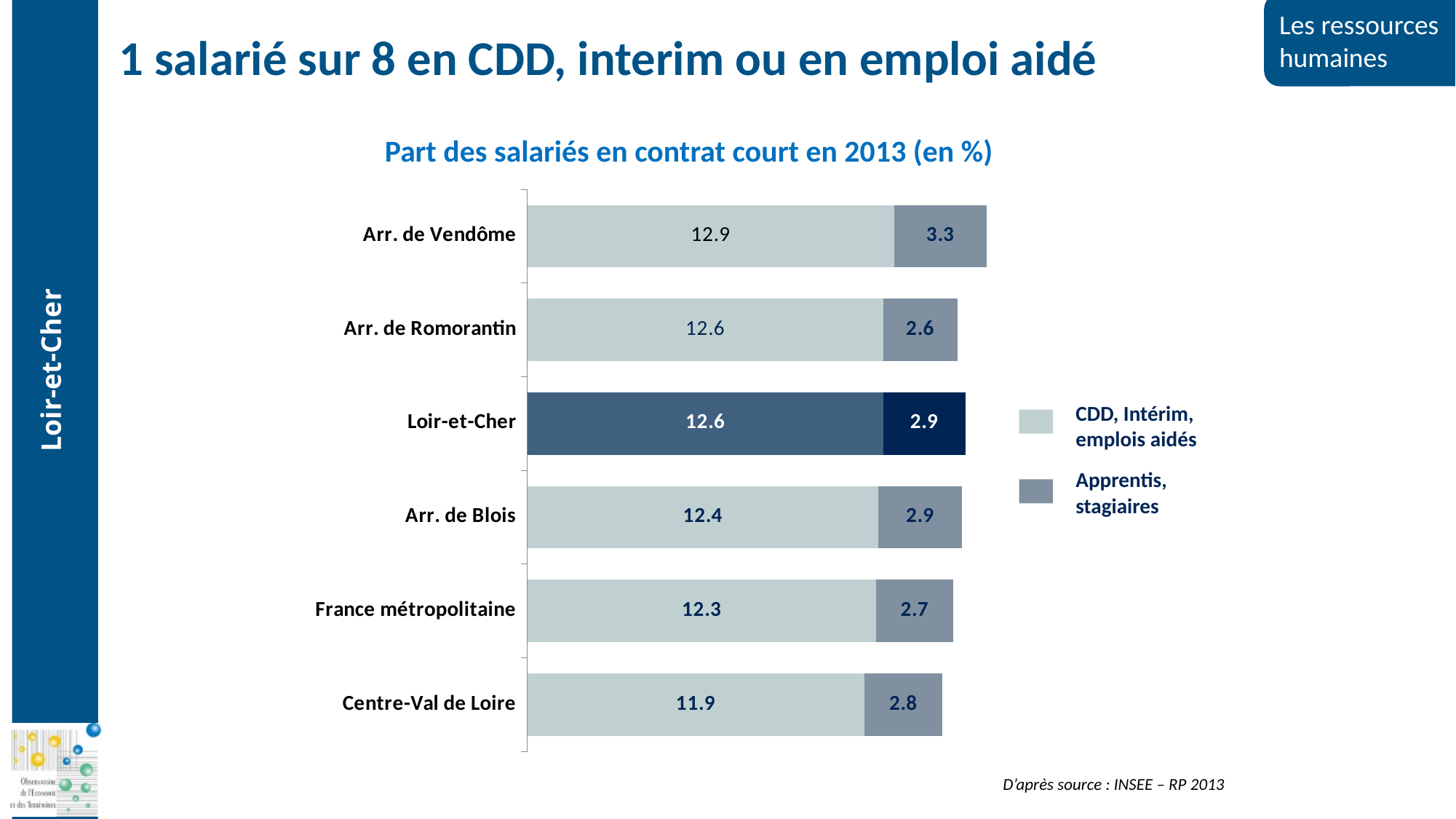
What is the value for 'CDD, Intérim, emplois aidés' for Centre-Val de Loire? 11.9 How many series does the legend list? 2 What kind of chart is shown on the slide? Stacked bar chart Which is larger: the 'Apprentis, stagiaires' value for Arr. de Romorantin or for France métropolitaine? France métropolitaine What is the total of the stacked bar for Centre-Val de Loire? 14.7 What is the value for 'Apprentis, stagiaires' for Loir-et-Cher? 2.9 Which category has the highest value for 'Apprentis, stagiaires'? Arr. de Vendôme What is the difference between the 'CDD, Intérim, emplois aidés' values for Arr. de Vendôme and Centre-Val de Loire? 1.0 What is the total of the stacked bar for Arr. de Vendôme? 16.2 Which category has the lowest value for 'CDD, Intérim, emplois aidés'? Centre-Val de Loire What is the value for 'CDD, Intérim, emplois aidés' for Arr. de Vendôme? 12.9 How many categories are shown on the chart? 6